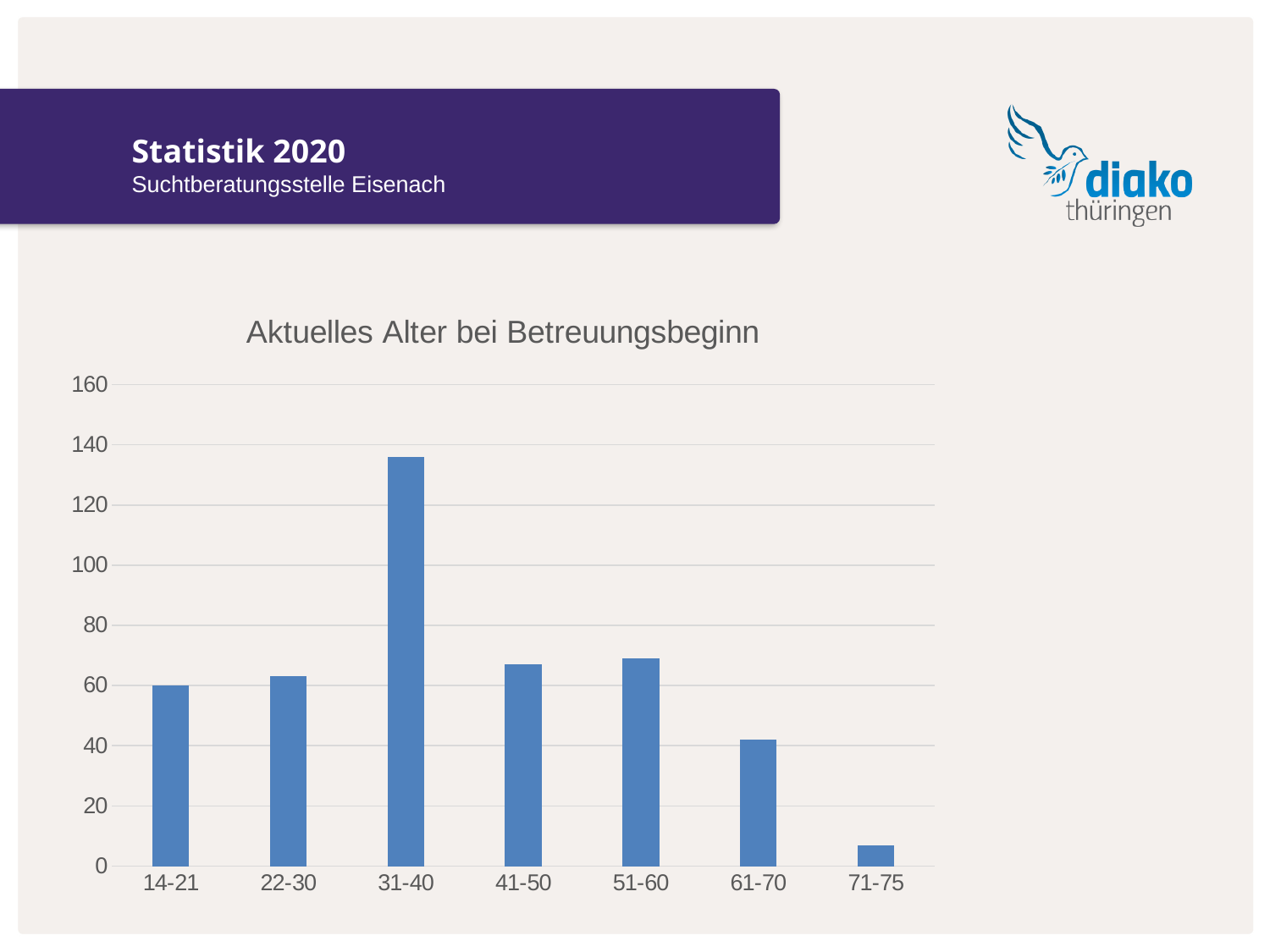
Is the value for 61-70 greater or less than 60? less Is the value for 71-75 greater or less than 20? less Which age category has the lowest value? 71-75 What is the highest value shown on the y axis? 160 What is the title of the chart? Aktuelles Alter bei Betreuungsbeginn What kind of chart is shown on the slide? bar chart Which is larger, the value for 31-40 or the value for 41-50? 31-40 Which is larger, the value for 51-60 or the value for 61-70? 51-60 Which age category has the highest value? 31-40 Is the value for 31-40 greater or less than 120? greater How many age categories are shown on the x axis? 7